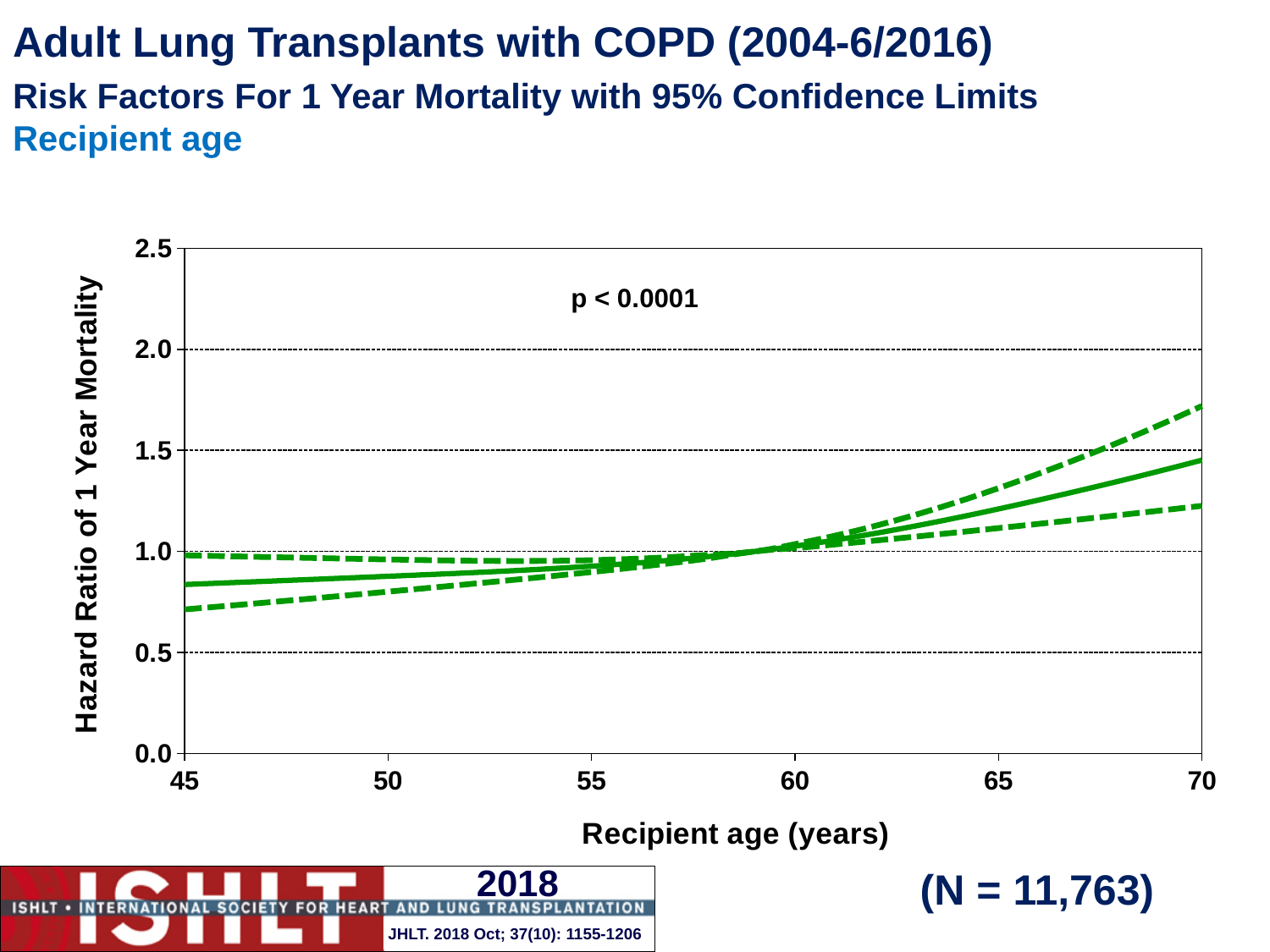
Is the hazard ratio (solid line) at recipient age 50 greater or less than 1.0? less How many lines are plotted on the chart? 3 Is the lower 95% confidence limit (lower dashed line) at recipient age 45 greater or less than 1.0? less What is the highest value shown on the y axis of the chart? 2.5 Is the hazard ratio (solid line) at recipient age 45 greater or less than 1.0? less What kind of chart is shown on the slide? line chart What p-value is printed on the chart? p < 0.0001 Does the hazard ratio of 1 year mortality rise or fall as recipient age increases from 45 to 70 years? rise